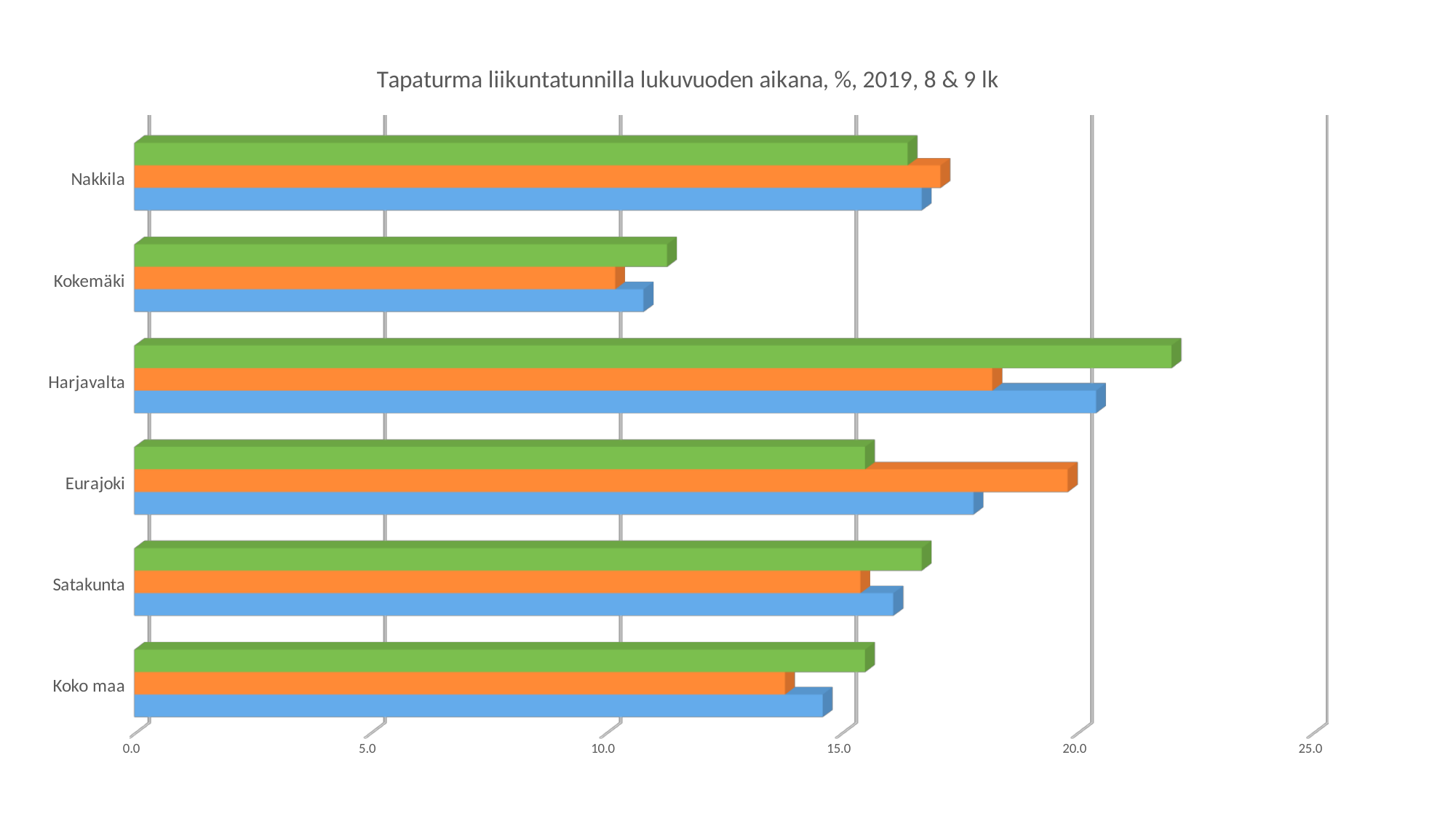
Which has the larger green bar, Kokemäki or Eurajoki? Eurajoki Is the value of the green bar for Harjavalta greater or less than 20.0? greater What is the title of the chart? Tapaturma liikuntatunnilla lukuvuoden aikana, %, 2019, 8 & 9 lk How many categories are shown on the vertical axis of the chart? 6 What kind of chart is shown on the slide? bar chart Which has the larger orange bar, Eurajoki or Satakunta? Eurajoki Which category has the longest green bar? Harjavalta How many bars are plotted for each category in the chart? 3 Is the value of the orange bar for Nakkila greater or less than 15.0? greater Which category has the shortest green bar? Kokemäki Is the value of the orange bar for Kokemäki greater or less than 15.0? less